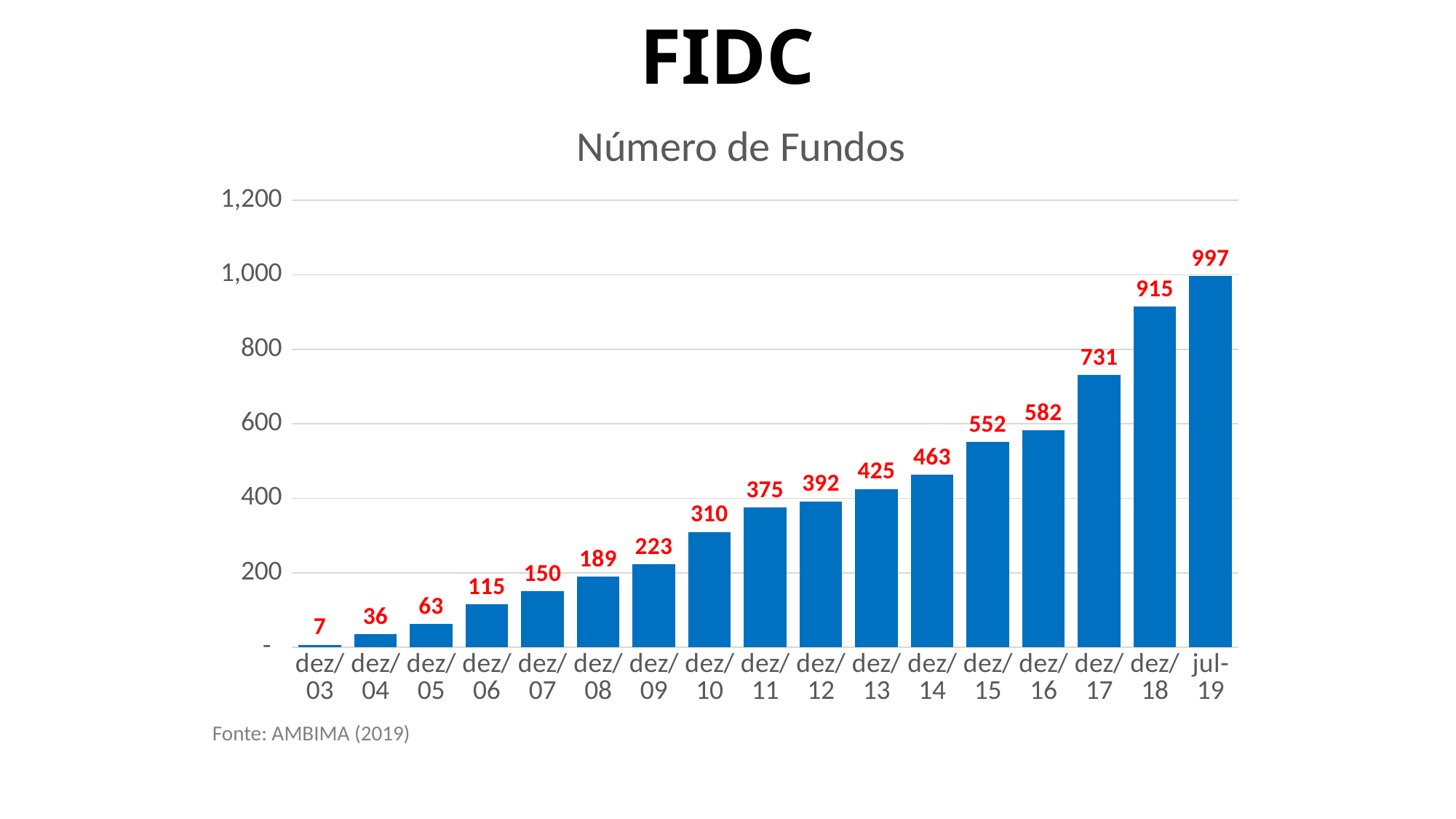
What is the title of the chart? Número de Fundos Which period has the lowest number of funds? dez/03 What is the value for dez/03? 7 How many periods are shown on the x axis? 17 What is the number of funds shown for dez/10? 310 Do the values rise or fall from dez/03 to jul-19? Rise Which is larger, the value for dez/12 or the value for dez/11? dez/12 Which period has the highest number of funds? jul-19 What is the difference between the values for jul-19 and dez/18? 82 What is the value for dez/17? 731 What is the difference between the values for dez/16 and dez/15? 30 What kind of chart is this? Bar chart